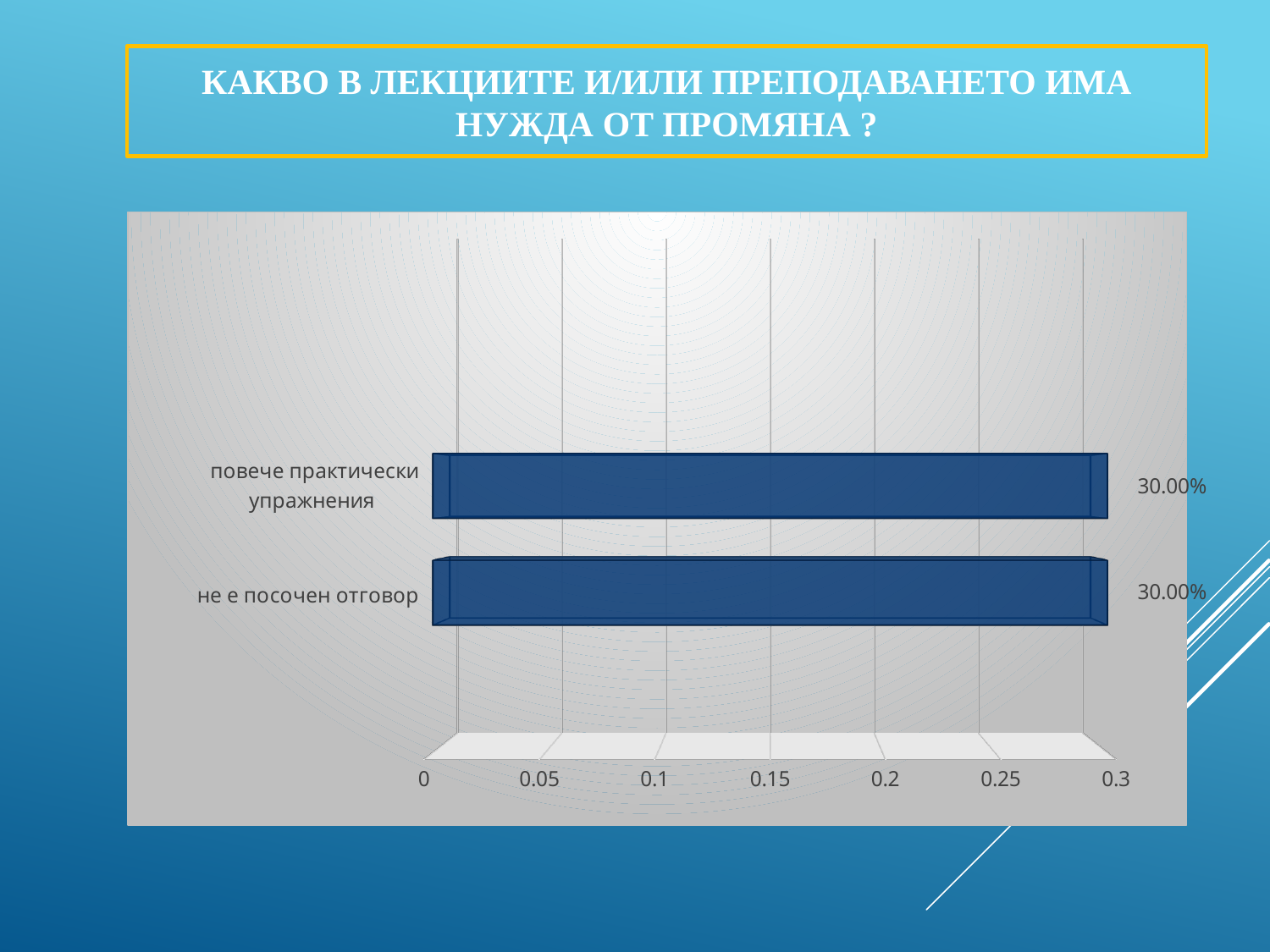
How many categories are shown in the chart? 2 Which is larger, the value for "повече практически упражнения" or the value for "не е посочен отговор"? They are equal What is the difference between the values for "повече практически упражнения" and "не е посочен отговор"? 0.00% What is the highest tick value shown on the horizontal axis? 0.3 What is the value for "повече практически упражнения"? 30.00% What is the title of the slide above the chart? КАКВО В ЛЕКЦИИТЕ И/ИЛИ ПРЕПОДАВАНЕТО ИМА НУЖДА ОТ ПРОМЯНА ? Is the value for "не е посочен отговор" greater or less than 0.2? greater Is the value for "повече практически упражнения" greater or less than 0.15? greater What kind of chart is shown on the slide? Bar chart What is the value for "не е посочен отговор"? 30.00%